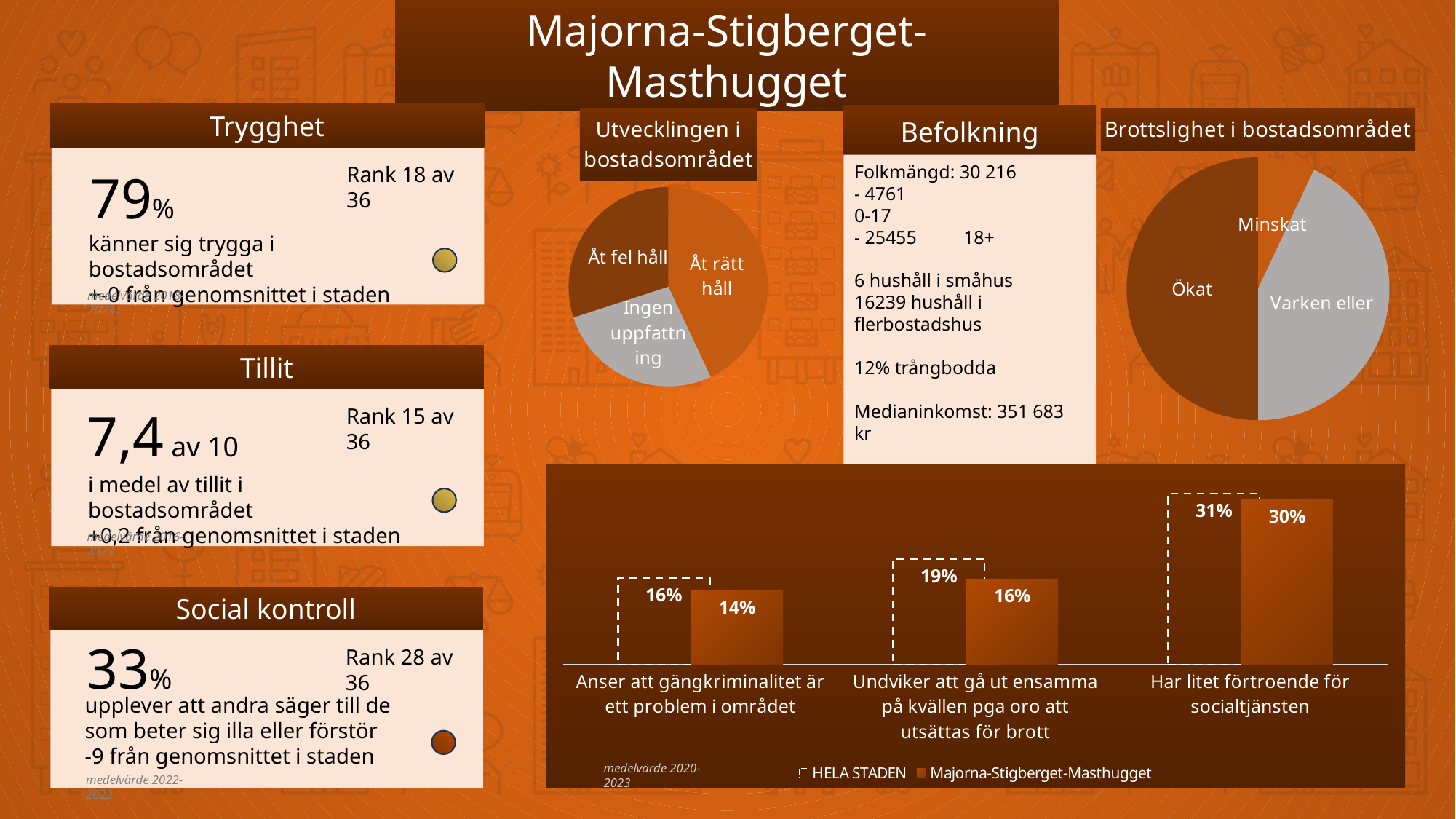
How many categories are shown in the bottom bar chart? 3 In the bottom bar chart, what is the value for HELA STADEN for 'Undviker att gå ut ensamma på kvällen pga oro att utsättas för brott'? 19% In the bottom bar chart, what is the difference between HELA STADEN and Majorna-Stigberget-Masthugget for 'Undviker att gå ut ensamma på kvällen pga oro att utsättas för brott'? 3% In the bottom bar chart, which category has the lowest value for HELA STADEN? Anser att gängkriminalitet är ett problem i området In the pie chart titled 'Utvecklingen i bostadsområdet', which slice is the smallest? Ingen uppfattning What kind of chart is the chart titled 'Brottslighet i bostadsområdet'? Pie chart In the pie chart titled 'Brottslighet i bostadsområdet', which slice is the largest? Ökat In the bottom bar chart, which is larger for 'Anser att gängkriminalitet är ett problem i området': HELA STADEN or Majorna-Stigberget-Masthugget? HELA STADEN How many series does the legend of the bottom bar chart list? 2 In the bottom bar chart, what is the value for Majorna-Stigberget-Masthugget for 'Har litet förtroende för socialtjänsten'? 30% In the bottom bar chart, which category has the highest value for Majorna-Stigberget-Masthugget? Har litet förtroende för socialtjänsten In the bottom bar chart, what is the value for Majorna-Stigberget-Masthugget for 'Anser att gängkriminalitet är ett problem i området'? 14%